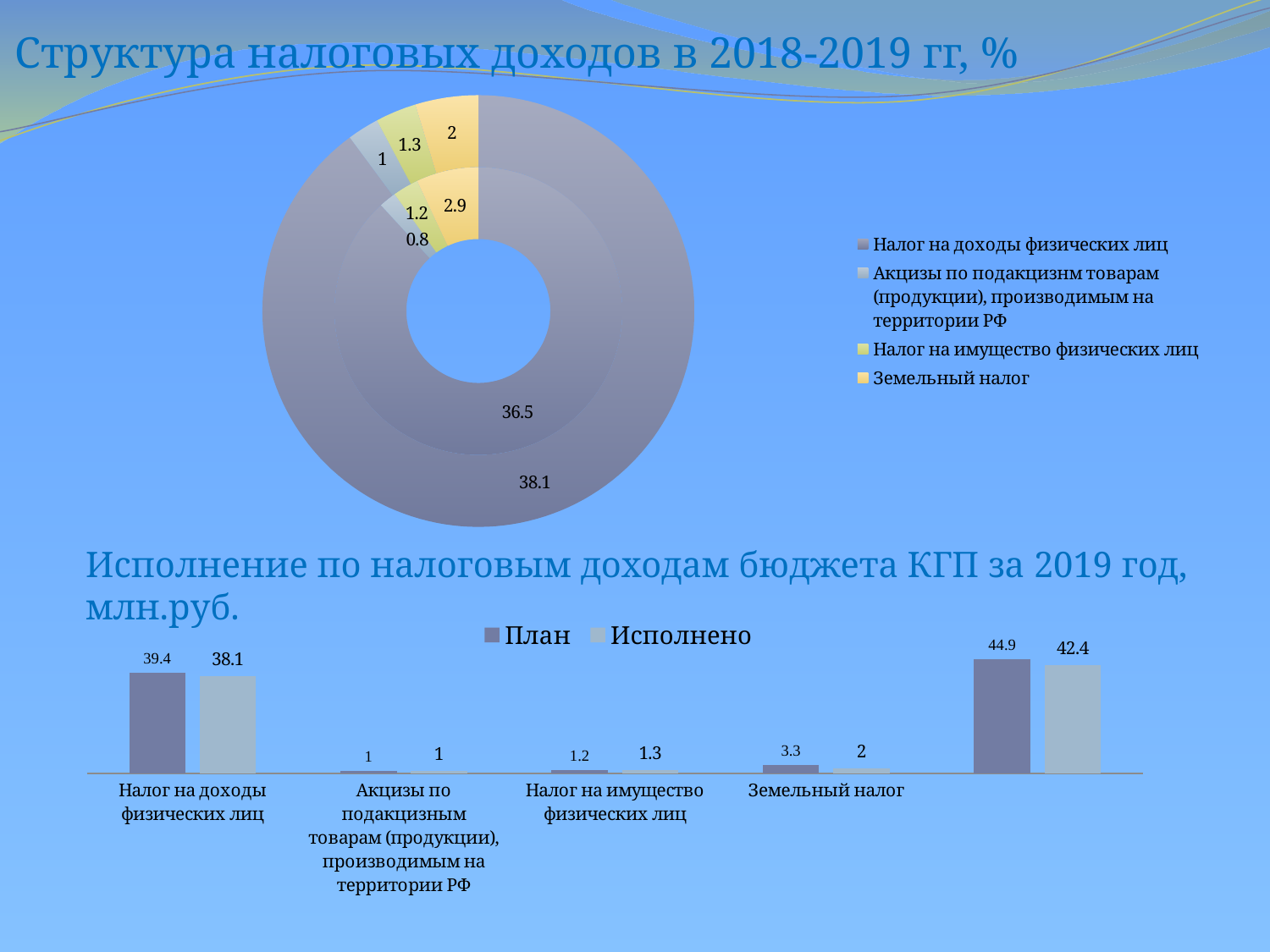
In the bottom bar chart, what is the Исполнено value for Земельный налог? 2 In the bottom bar chart, how many series does the legend list? 2 In the bottom bar chart, for Земельный налог, which is larger: План or Исполнено? План In the top doughnut chart, how many categories does the legend list? 4 What kind of chart is the top chart on the slide? Doughnut chart What is the title of the bottom chart? Исполнение по налоговым доходам бюджета КГП за 2019 год, млн.руб. In the bottom bar chart, what is the Исполнено value for Налог на имущество физических лиц? 1.3 In the top doughnut chart, what is the largest value shown on the outer ring? 38.1 In the bottom bar chart, what is the difference between План and Исполнено for Земельный налог? 1.3 In the bottom bar chart, what is the План value for Налог на доходы физических лиц? 39.4 In the bottom bar chart, what is the difference between the План and Исполнено values for Налог на доходы физических лиц? 1.3 What kind of chart is the bottom chart on the slide? Bar chart